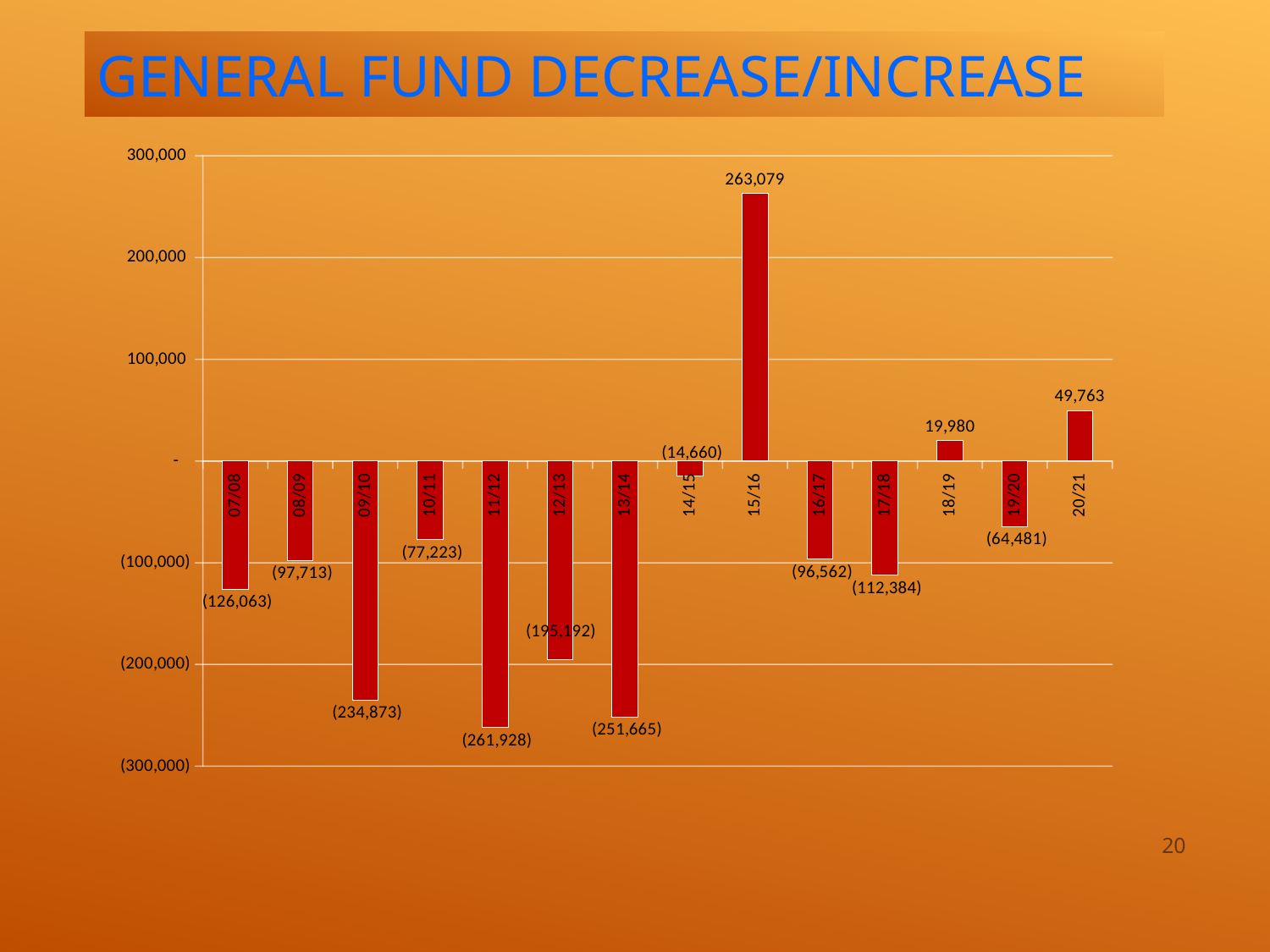
What is the value for 14/15? (14,660) What kind of chart is shown on the slide? Bar chart What is the difference between the values for 15/16 and 20/21? 213,316 How many years are shown on the x axis? 14 What is the value for 20/21? 49,763 Which year has the highest value? 15/16 What is the difference between the values for 20/21 and 18/19? 29,783 Which year has the lowest value? 11/12 What is the value for 11/12? (261,928) Which is larger, the value for 18/19 or the value for 20/21? 20/21 What is the value for 15/16? 263,079 How many years show a positive (increase) value? 3